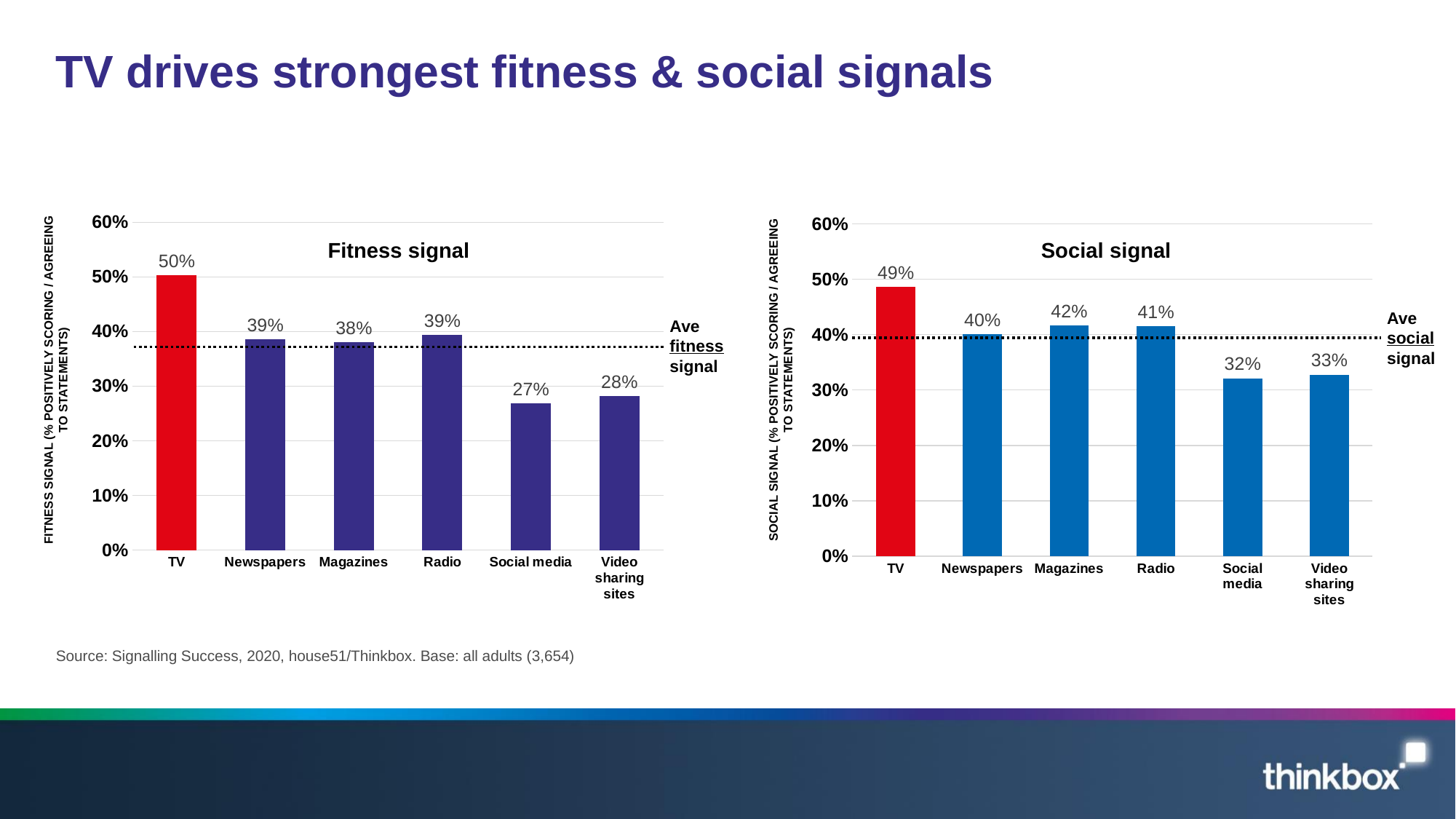
In the Fitness signal chart, what is the value for TV? 50% In the Social signal chart, what is the difference between the values for TV and Video sharing sites? 16% In the Fitness signal chart, which category has the lowest value? Social media In the Social signal chart, which category has the highest value? TV In the Social signal chart, which is larger, the value for Magazines or the value for Social media? Magazines In the Fitness signal chart, what does the dotted horizontal line represent? Ave fitness signal In the Fitness signal chart, is the value for Video sharing sites greater or less than 30%? less In the Social signal chart, what is the value for Radio? 41% How many categories are shown in the Fitness signal chart? 6 What kind of chart is the Social signal chart? Bar chart In the Fitness signal chart, what is the difference between the values for TV and Social media? 23% In the Social signal chart, what is the value for Magazines? 42%